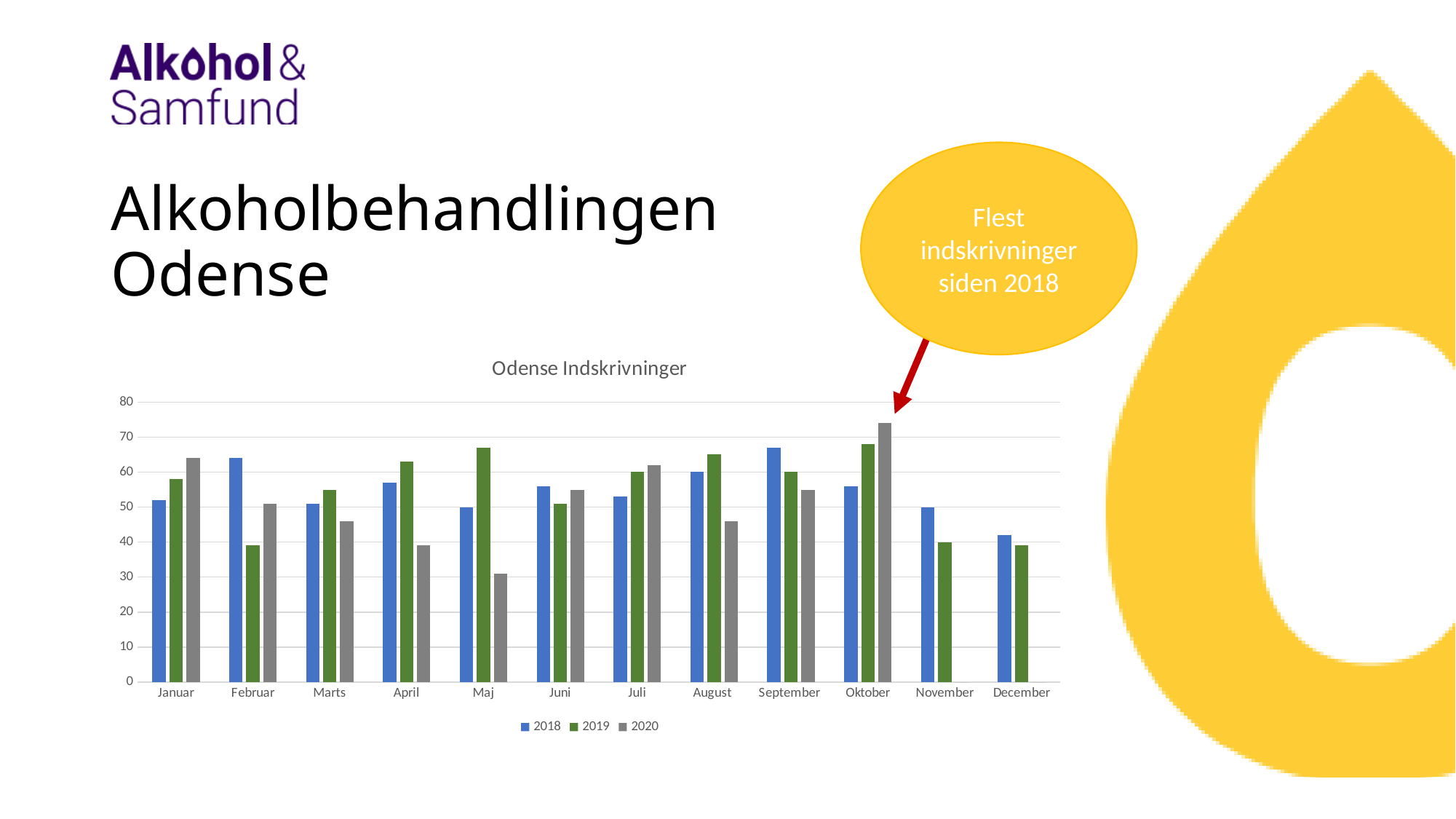
What kind of chart is shown on the slide? Bar chart How many series does the legend of the chart list? 3 How many months are shown on the x axis of the chart? 12 For how many months does the chart show a 2020 bar? 10 Which month and year has the lowest bar in the chart? Maj 2020 Is the value for Februar 2018 greater or less than 60? greater What is the title of the chart? Odense Indskrivninger Which month and year has the highest bar in the chart? Oktober 2020 Which is larger in Maj: the 2019 bar or the 2020 bar? 2019 Is the value for Maj 2020 greater or less than 40? less Is the value for Oktober 2020 greater or less than 70? greater Which is larger in Februar: the 2018 bar or the 2019 bar? 2018